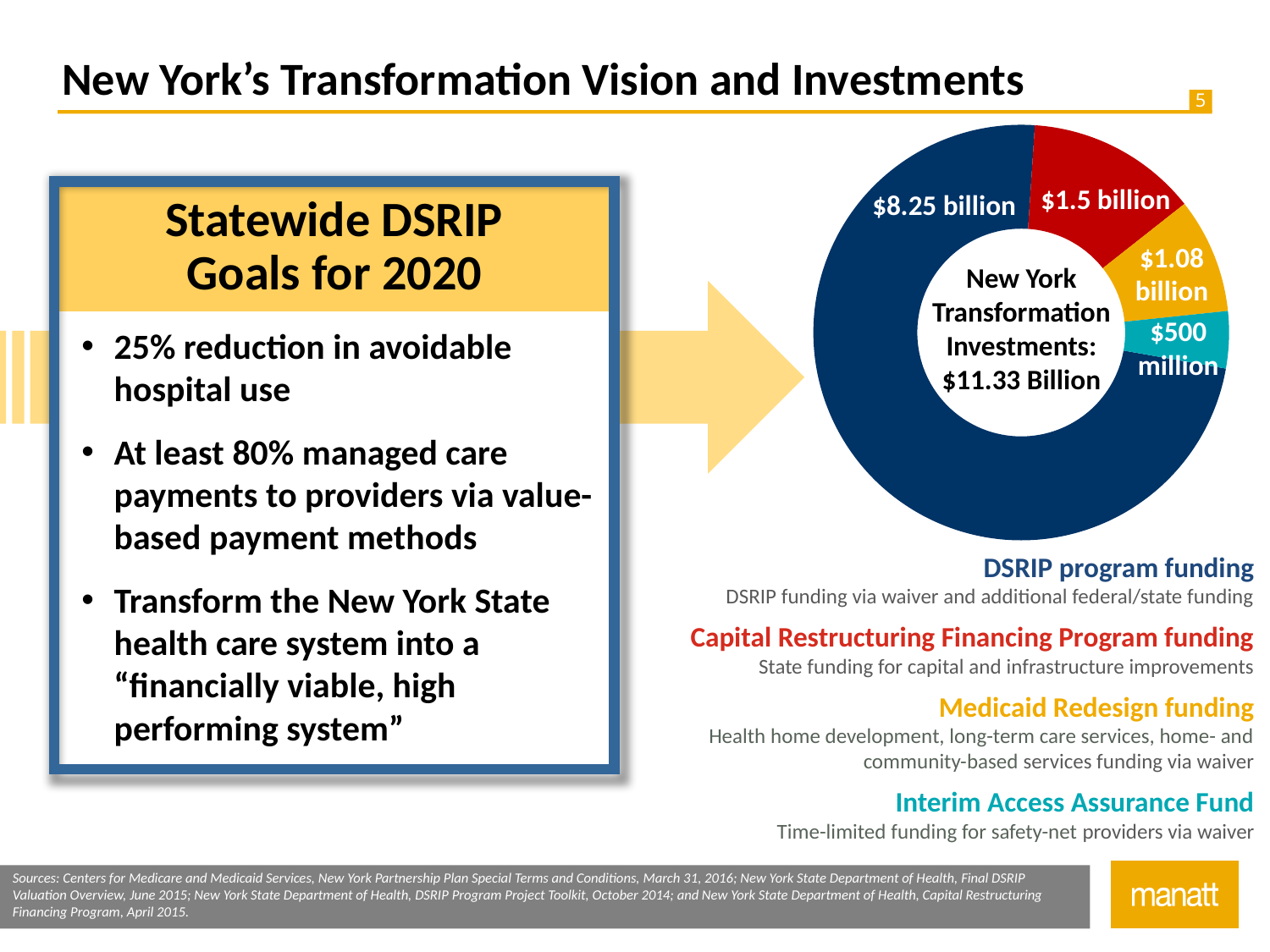
What colour is the Medicaid Redesign funding slice? Gold What is the value of the Interim Access Assurance Fund slice? $500 million Which funding category is the largest slice of the chart? DSRIP program funding What is the value of the Medicaid Redesign funding slice? $1.08 billion What is the total of New York Transformation Investments shown in the center of the chart? $11.33 Billion How many slices does the chart have? 4 Which funding category is the smallest slice of the chart? Interim Access Assurance Fund Which is larger, the Capital Restructuring Financing Program funding slice or the Medicaid Redesign funding slice? Capital Restructuring Financing Program funding What kind of chart is shown on the slide? Pie chart (donut) What is the difference between the DSRIP program funding slice and the Capital Restructuring Financing Program funding slice? $6.75 billion What is the value of the DSRIP program funding slice? $8.25 billion What is the value of the Capital Restructuring Financing Program funding slice? $1.5 billion